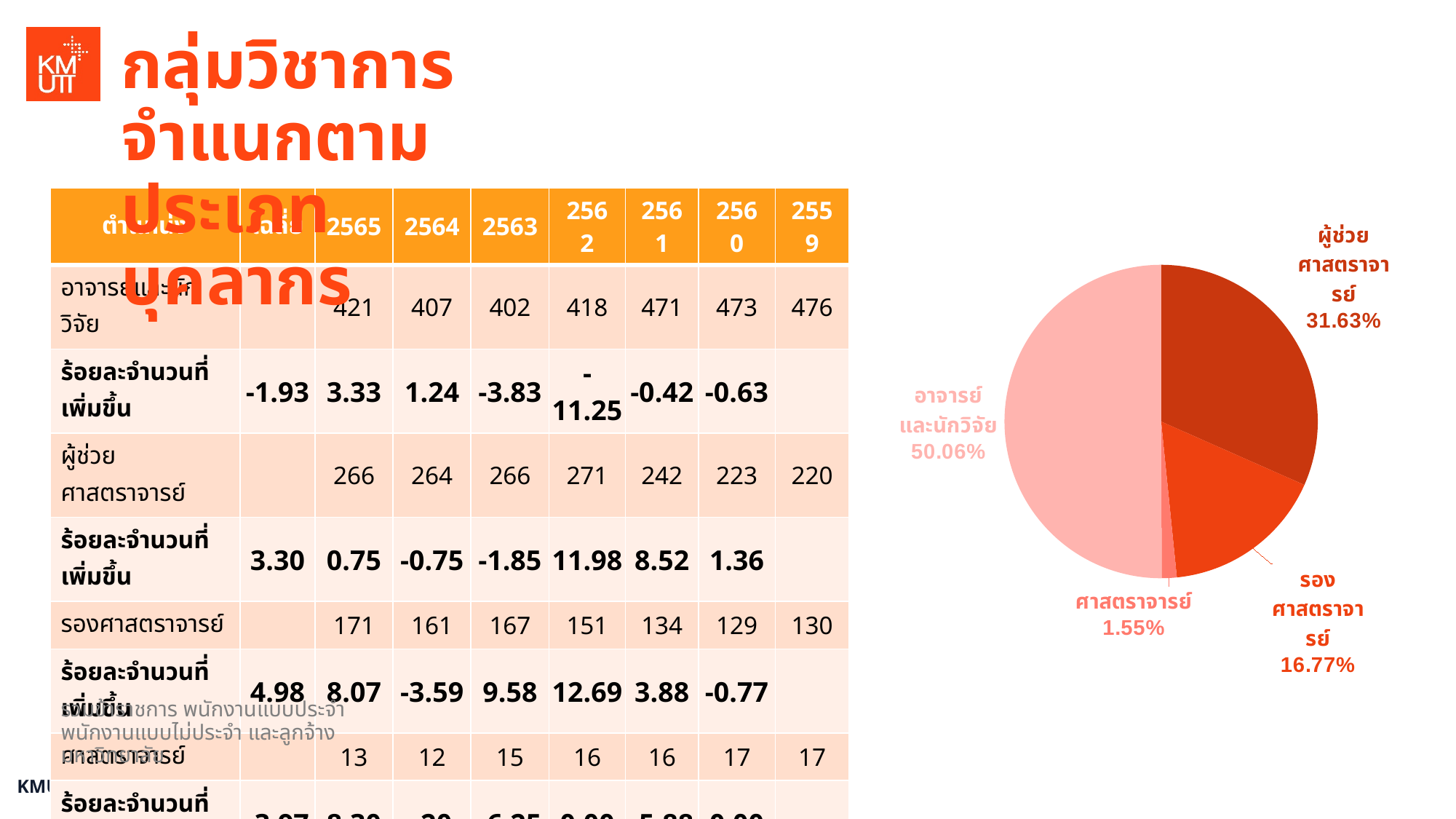
What kind of chart is shown on the right side of the slide? pie chart In the pie chart, what is the difference in percentage points between the อาจารย์และนักวิจัย slice and the ศาสตราจารย์ slice? 48.51 What share of the pie chart is labelled ศาสตราจารย์? 1.55% In the pie chart, which slice is larger: ผู้ช่วยศาสตราจารย์ or รองศาสตราจารย์? ผู้ช่วยศาสตราจารย์ Which category has the largest slice in the pie chart? อาจารย์และนักวิจัย In the pie chart, which slice is drawn in the darkest red colour? ผู้ช่วยศาสตราจารย์ What share of the pie chart is labelled รองศาสตราจารย์? 16.77% How many slices does the pie chart have? 4 In the pie chart, what is the difference in percentage points between the ผู้ช่วยศาสตราจารย์ slice and the รองศาสตราจารย์ slice? 14.86 What share of the pie chart is labelled อาจารย์และนักวิจัย? 50.06% Which category has the smallest slice in the pie chart? ศาสตราจารย์